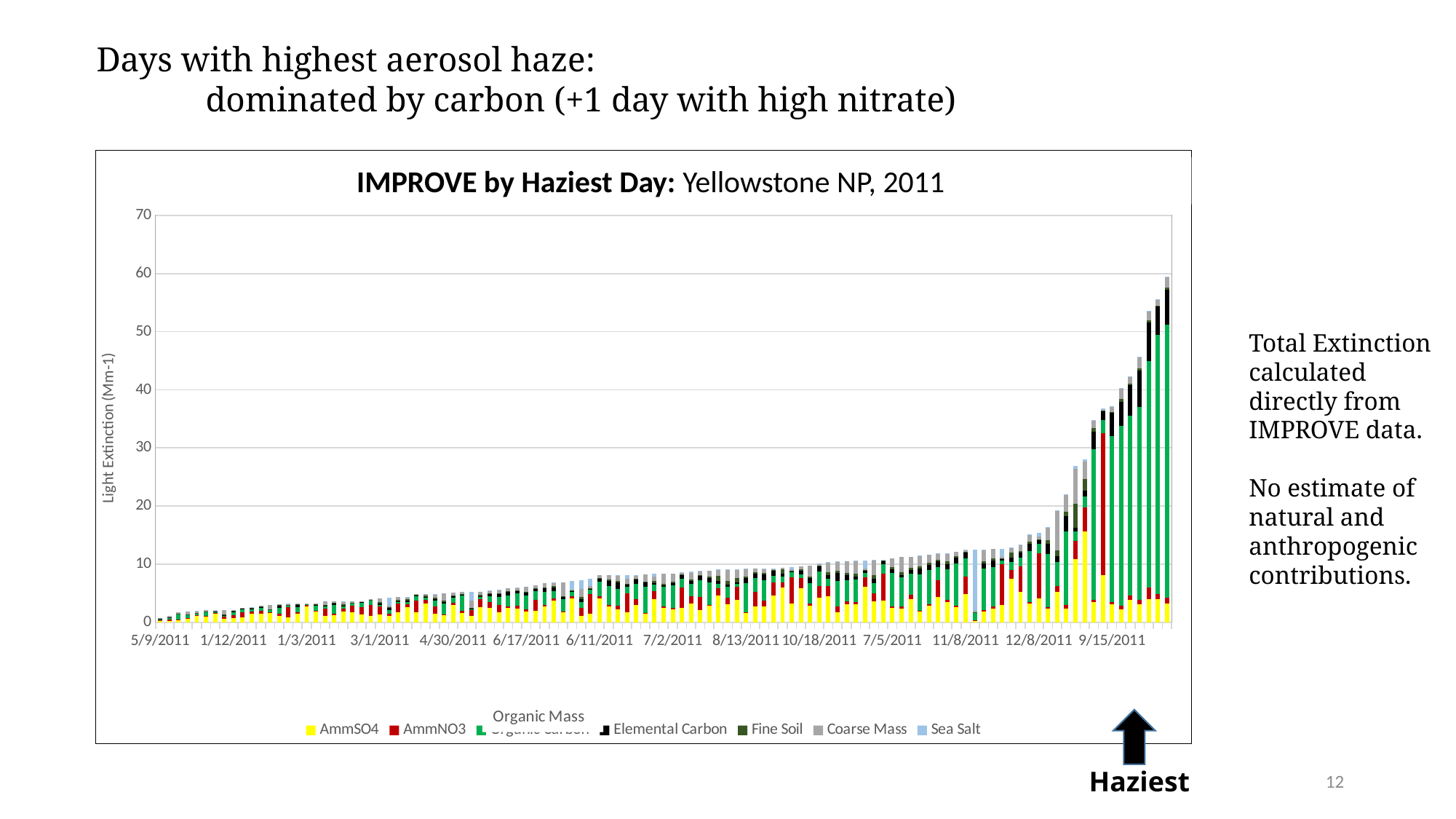
What is the highest tick value shown on the vertical axis? 70 What is the label of the vertical axis of the chart? Light Extinction (Mm-1) What is the title of the chart? IMPROVE by Haziest Day: Yellowstone NP, 2011 Do the bar totals rise or fall moving from left to right along the x axis? rise How many series does the chart legend list? 7 Is the total value of the tallest bar in the chart greater or less than 50? greater What kind of chart is shown on the slide? Stacked bar chart Which series makes up the largest part of the tallest bars on the right side of the chart? Organic Carbon Is the total value of the bar at 5/9/2011 greater or less than 10? less